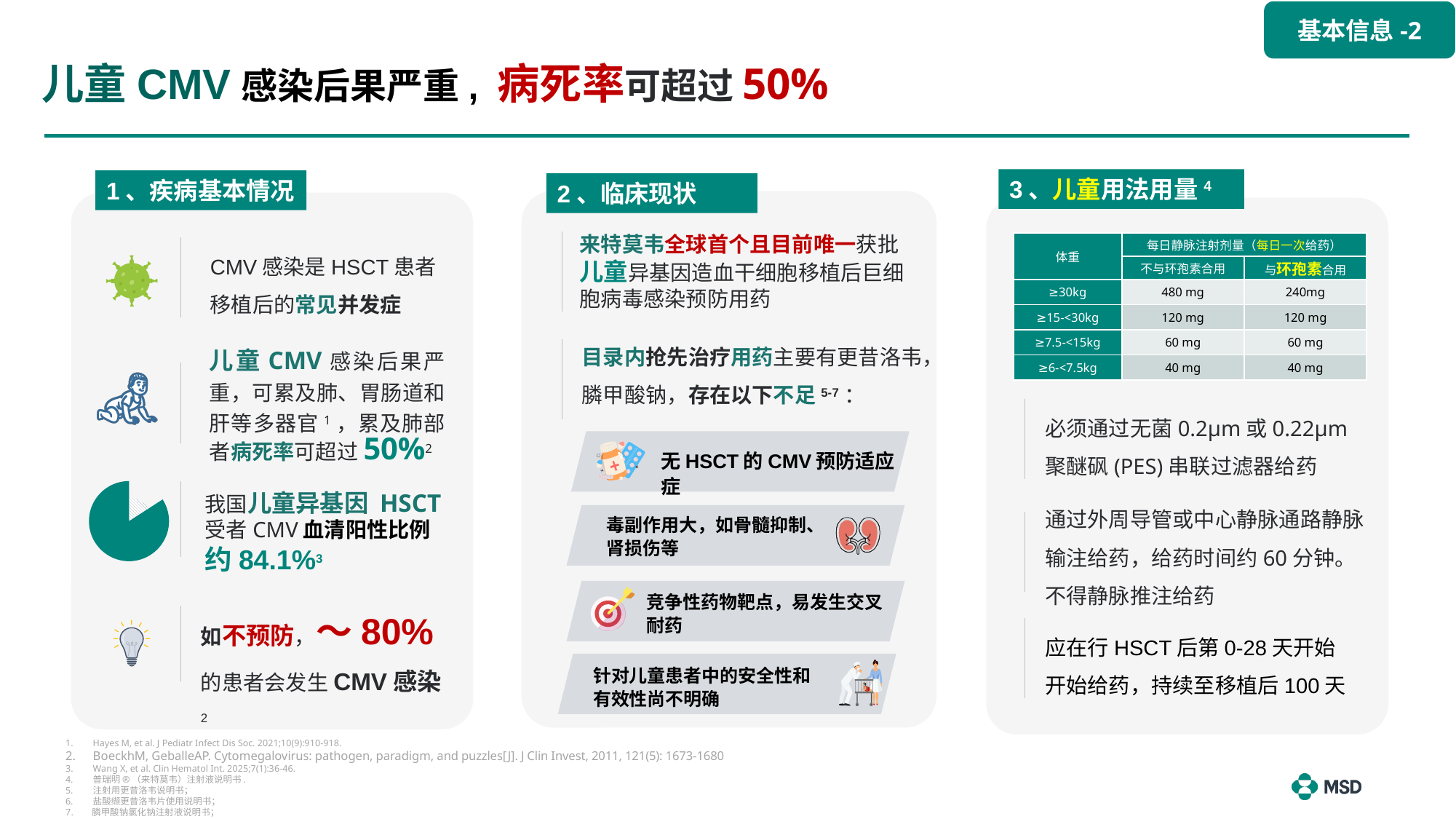
What share does the pie chart in the first panel represent for CMV seropositivity among pediatric allogeneic HSCT recipients in China? 约 84.1% What kind of chart is the small graphic next to the text about the CMV seropositivity rate in the first panel? pie chart What colour is the filled slice of the pie chart in the first panel? green Is the share shown by the pie chart in the first panel greater or less than 50%? greater